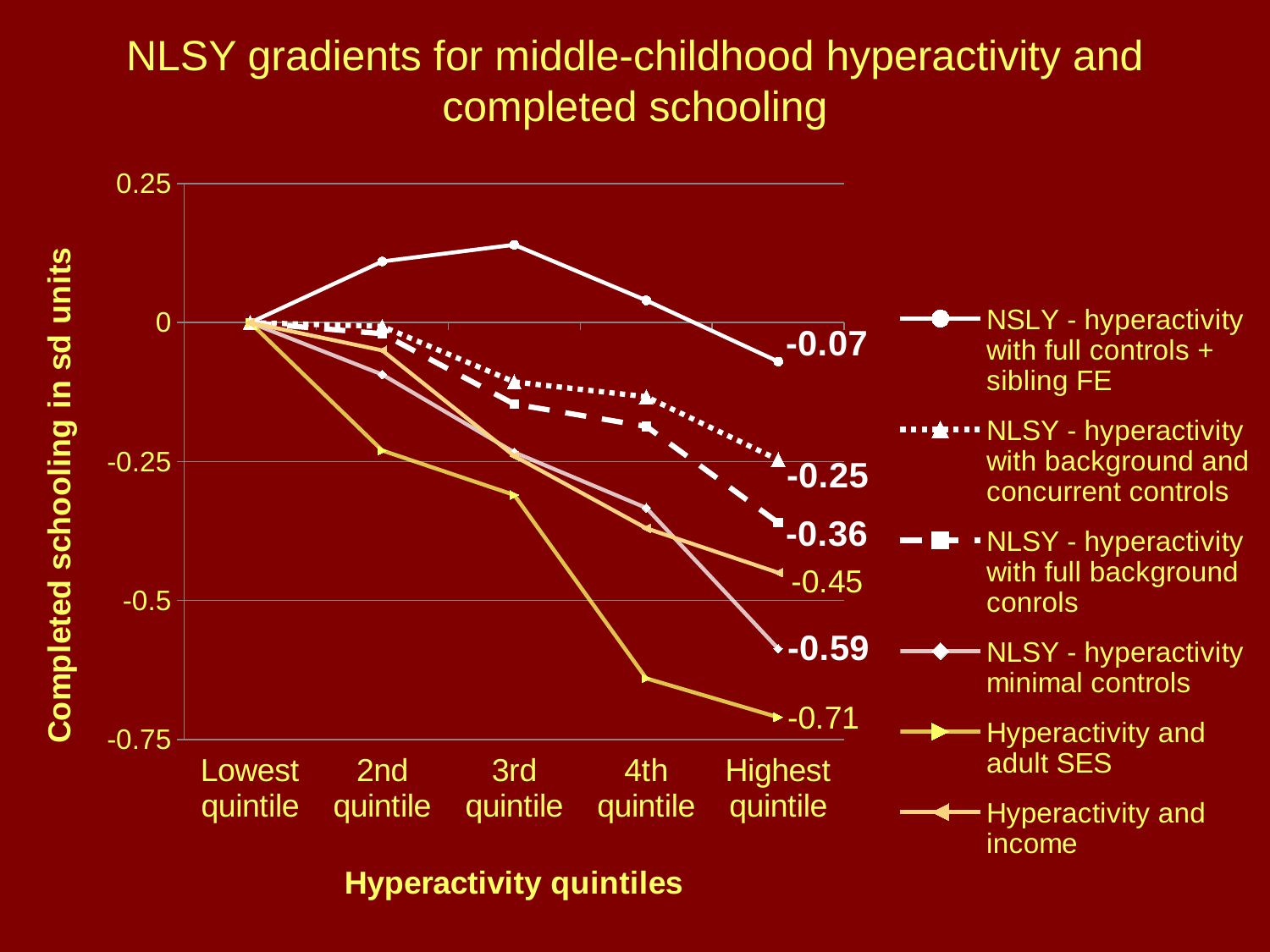
What is the value for 'NSLY - hyperactivity with full controls + sibling FE' at the Highest quintile? -0.07 How many series does the legend list? 6 What kind of chart is shown on the slide? line chart What is the value for 'NLSY - hyperactivity minimal controls' at the Highest quintile? -0.59 Which series has the highest value at the Highest quintile? NSLY - hyperactivity with full controls + sibling FE What is the value for 'Hyperactivity and adult SES' at the Highest quintile? -0.71 What is the value for 'Hyperactivity and income' at the Highest quintile? -0.45 At the Highest quintile, which is larger: 'NLSY - hyperactivity with full background conrols' or 'Hyperactivity and income'? NLSY - hyperactivity with full background conrols How many hyperactivity quintiles are plotted along the x axis? 5 Which series has the lowest value at the Highest quintile? Hyperactivity and adult SES Is the value for 'Hyperactivity and adult SES' at the 4th quintile greater or less than -0.5? less What is the difference between the Highest quintile values for 'NSLY - hyperactivity with full controls + sibling FE' (-0.07) and 'Hyperactivity and adult SES' (-0.71)? 0.64